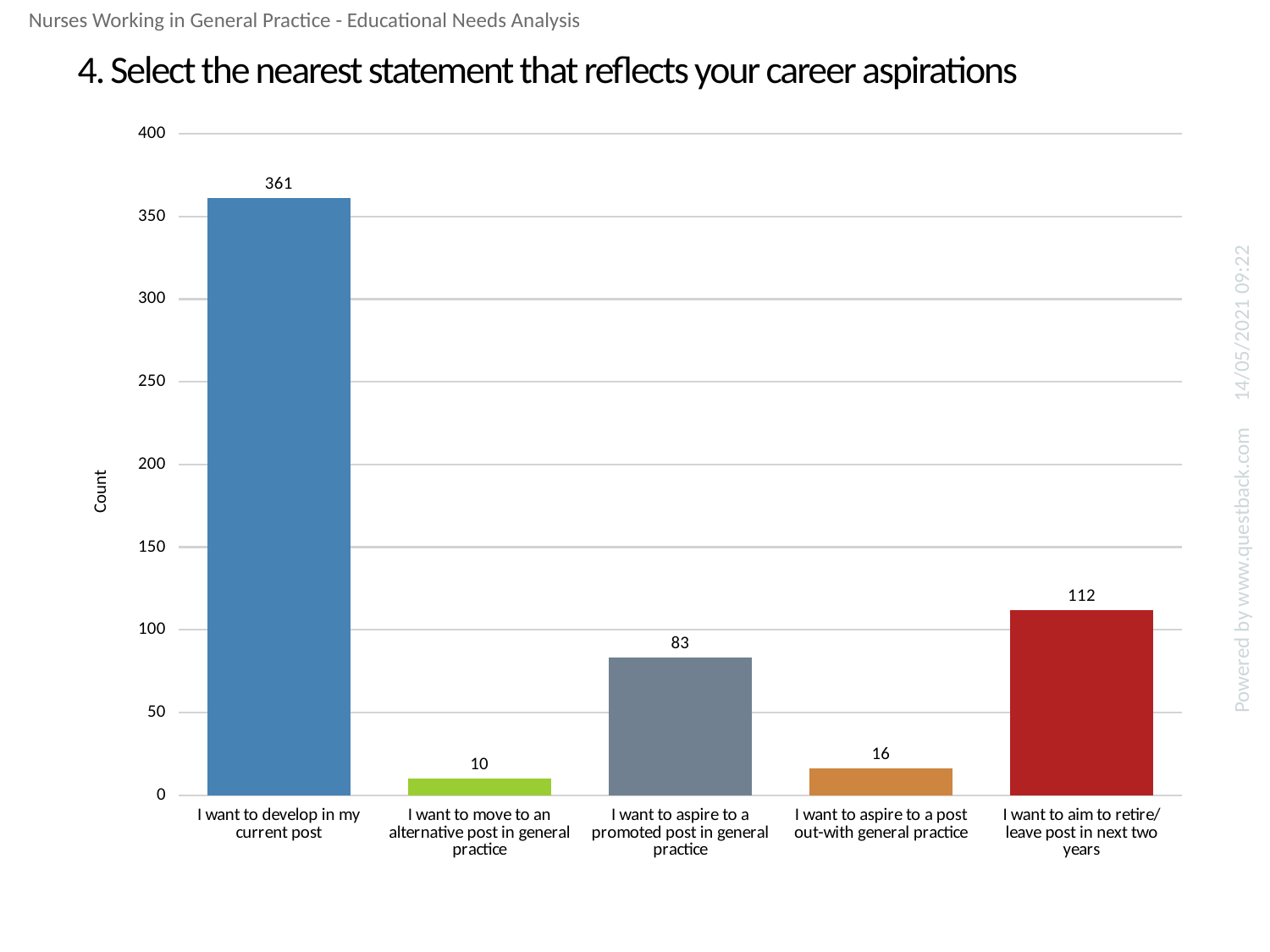
Which career aspiration statement has the lowest count? I want to move to an alternative post in general practice What is the count for 'I want to aim to retire/leave post in next two years'? 112 Is the count for 'I want to aim to retire/leave post in next two years' greater or less than 100? greater What is the label of the y-axis? Count Which career aspiration statement has the highest count? I want to develop in my current post Which has a larger count: 'I want to aspire to a promoted post in general practice' or 'I want to aspire to a post out-with general practice'? I want to aspire to a promoted post in general practice What is the difference between the counts for 'I want to aspire to a post out-with general practice' and 'I want to move to an alternative post in general practice'? 6 What kind of chart is shown on the slide? Bar chart What is the count for 'I want to develop in my current post'? 361 How many career aspiration categories are shown in the chart? 5 What is the difference between the counts for 'I want to develop in my current post' and 'I want to aim to retire/leave post in next two years'? 249 What is the count for 'I want to aspire to a promoted post in general practice'? 83